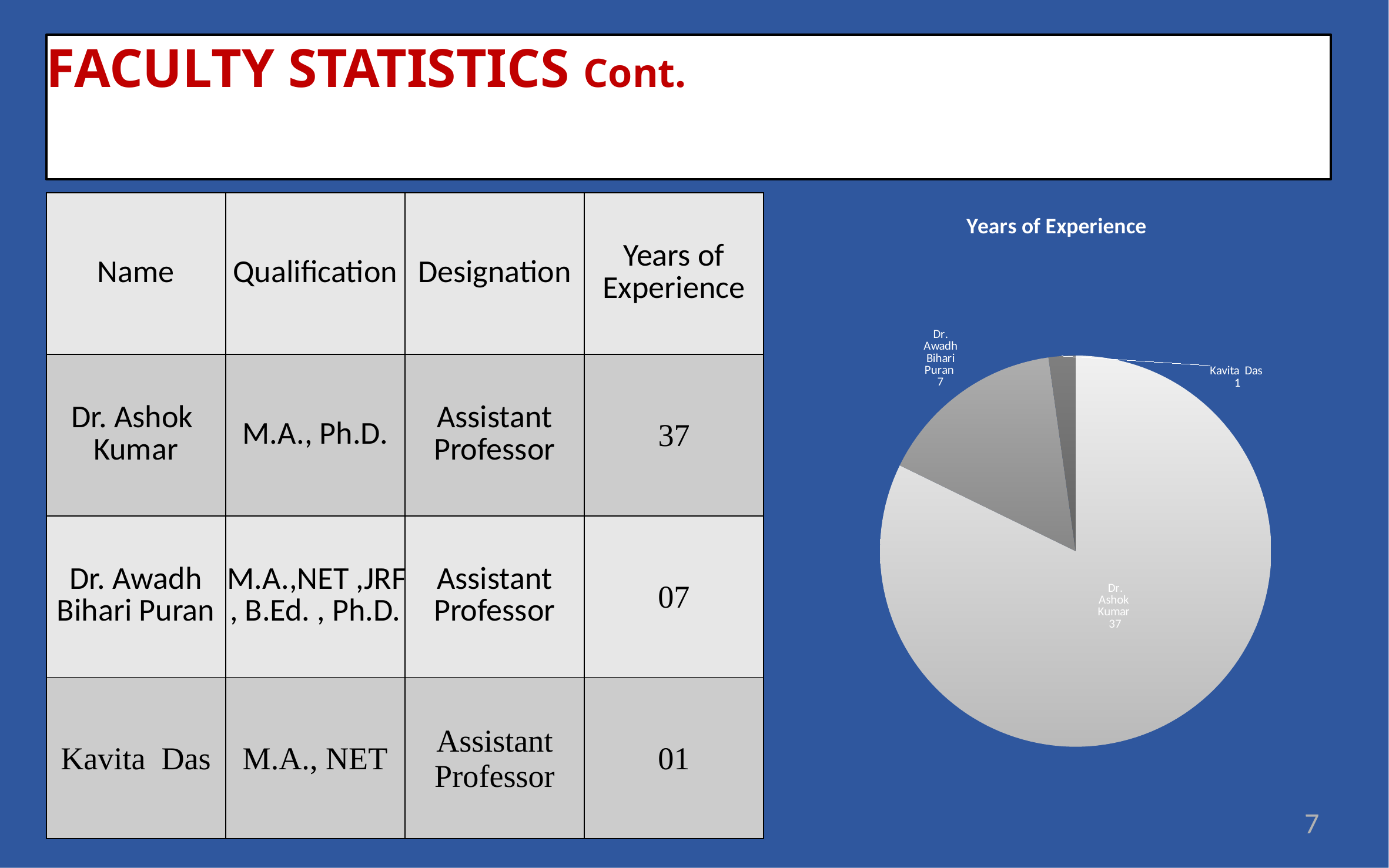
Which person has the smallest slice in the pie chart? Kavita Das Which person has the largest slice in the pie chart? Dr. Ashok Kumar What is the value shown for Dr. Ashok Kumar in the pie chart? 37 What is the value shown for Dr. Awadh Bihari Puran in the pie chart? 7 What is the title of the chart? Years of Experience How many slices does the pie chart have? 3 What is the total of all the values in the pie chart? 45 Which is larger in the pie chart, the value for Dr. Awadh Bihari Puran or the value for Kavita Das? Dr. Awadh Bihari Puran What type of chart is shown on the slide? pie chart What is the value shown for Kavita Das in the pie chart? 1 What is the difference between the values for Dr. Awadh Bihari Puran and Kavita Das in the pie chart? 6 What is the difference between the values for Dr. Ashok Kumar and Dr. Awadh Bihari Puran in the pie chart? 30